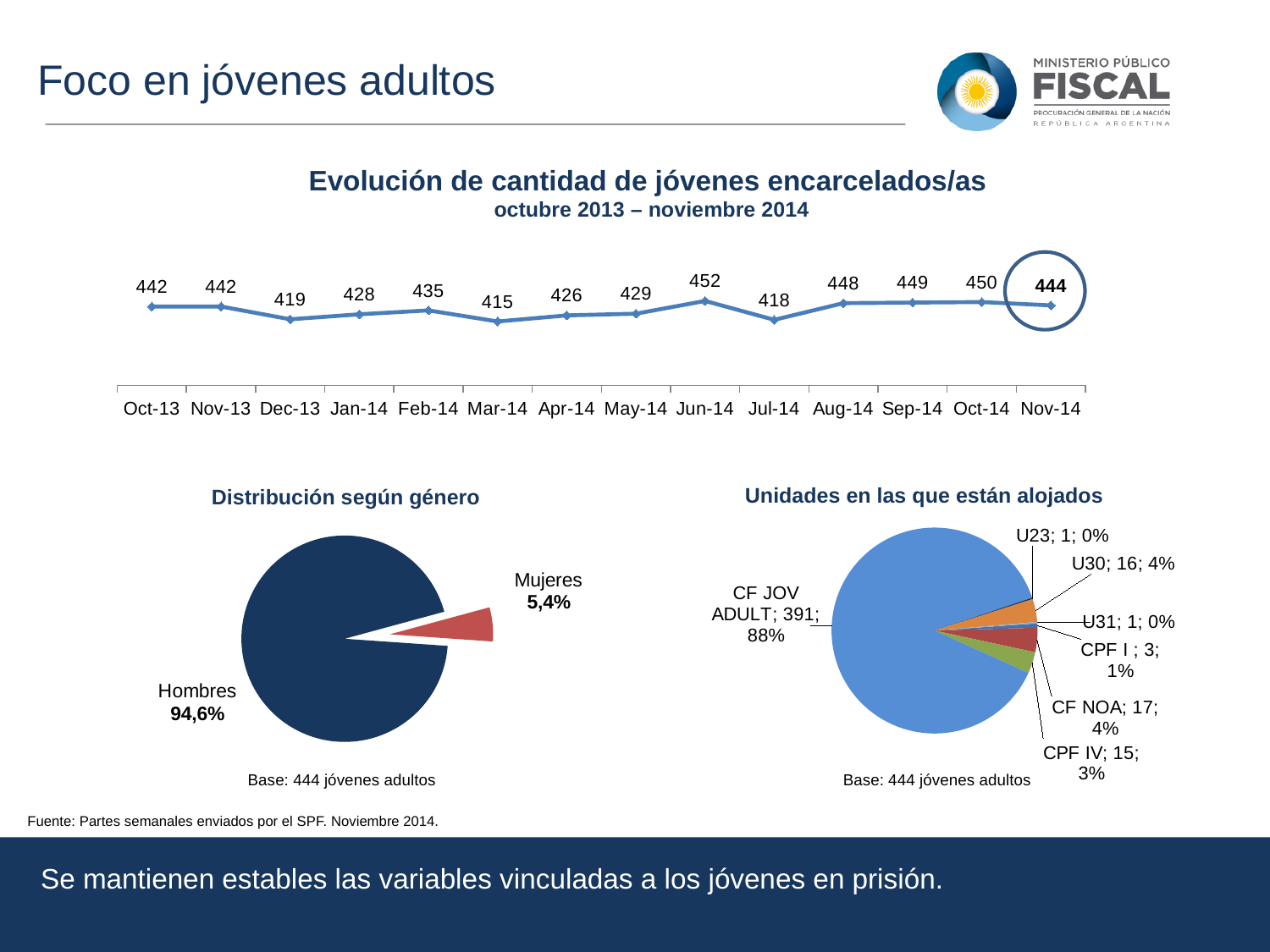
In the 'Evolución de cantidad de jóvenes encarcelados/as' chart, what is the value for Nov-14? 444 In the 'Unidades en las que están alojados' chart, what is the value for CF NOA? 17 In the 'Evolución de cantidad de jóvenes encarcelados/as' chart, which month has the highest value? Jun-14 In the 'Evolución de cantidad de jóvenes encarcelados/as' chart, which month has the lowest value? Mar-14 In the 'Evolución de cantidad de jóvenes encarcelados/as' chart, what is the value for Jun-14? 452 In the 'Unidades en las que están alojados' chart, which is larger, U30 or CPF IV? U30 In the 'Evolución de cantidad de jóvenes encarcelados/as' chart, how many months are plotted? 14 What kind of chart is 'Evolución de cantidad de jóvenes encarcelados/as'? Line chart In the 'Distribución según género' chart, what share is Hombres? 94,6% In the 'Unidades en las que están alojados' chart, which unit has the largest slice? CF JOV ADULT In the 'Distribución según género' chart, what share is Mujeres? 5,4% In the 'Evolución de cantidad de jóvenes encarcelados/as' chart, what is the difference between the values for Jun-14 and Jul-14? 34